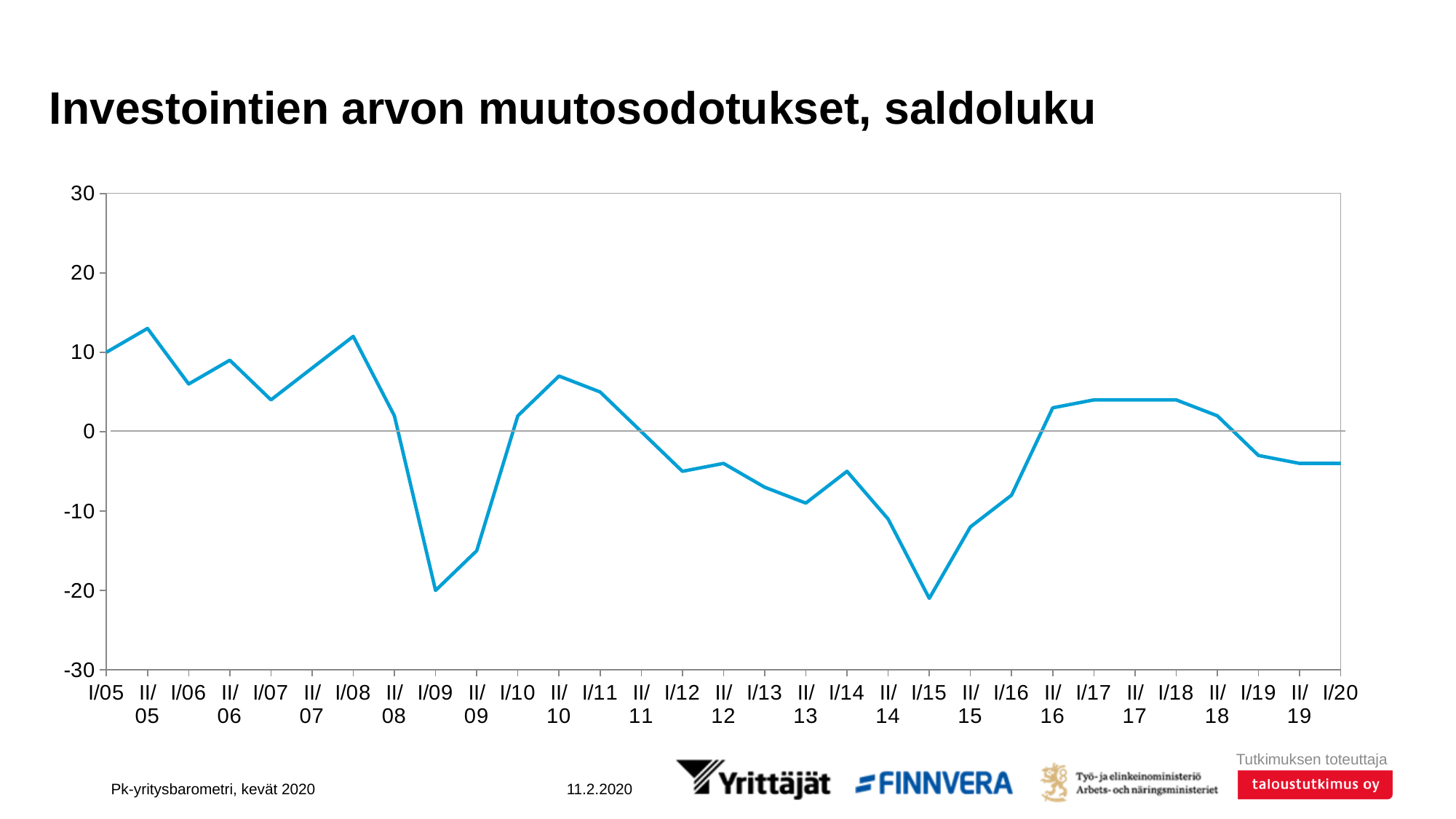
What is the title of the chart? Investointien arvon muutosodotukset, saldoluku What kind of chart is shown on the slide? line chart Which is larger, the value for II/05 or the value for I/15? II/05 Is the value for II/05 greater or less than 10? greater Do the values rise or fall from I/15 to I/17? rise Is the value for I/15 greater or less than -10? less How many data points are plotted on the line, from I/05 to I/20? 31 Is the value for I/17 greater or less than 0? greater Do the values rise or fall from I/08 to I/09? fall Which is larger, the value for I/09 or the value for I/10? I/10